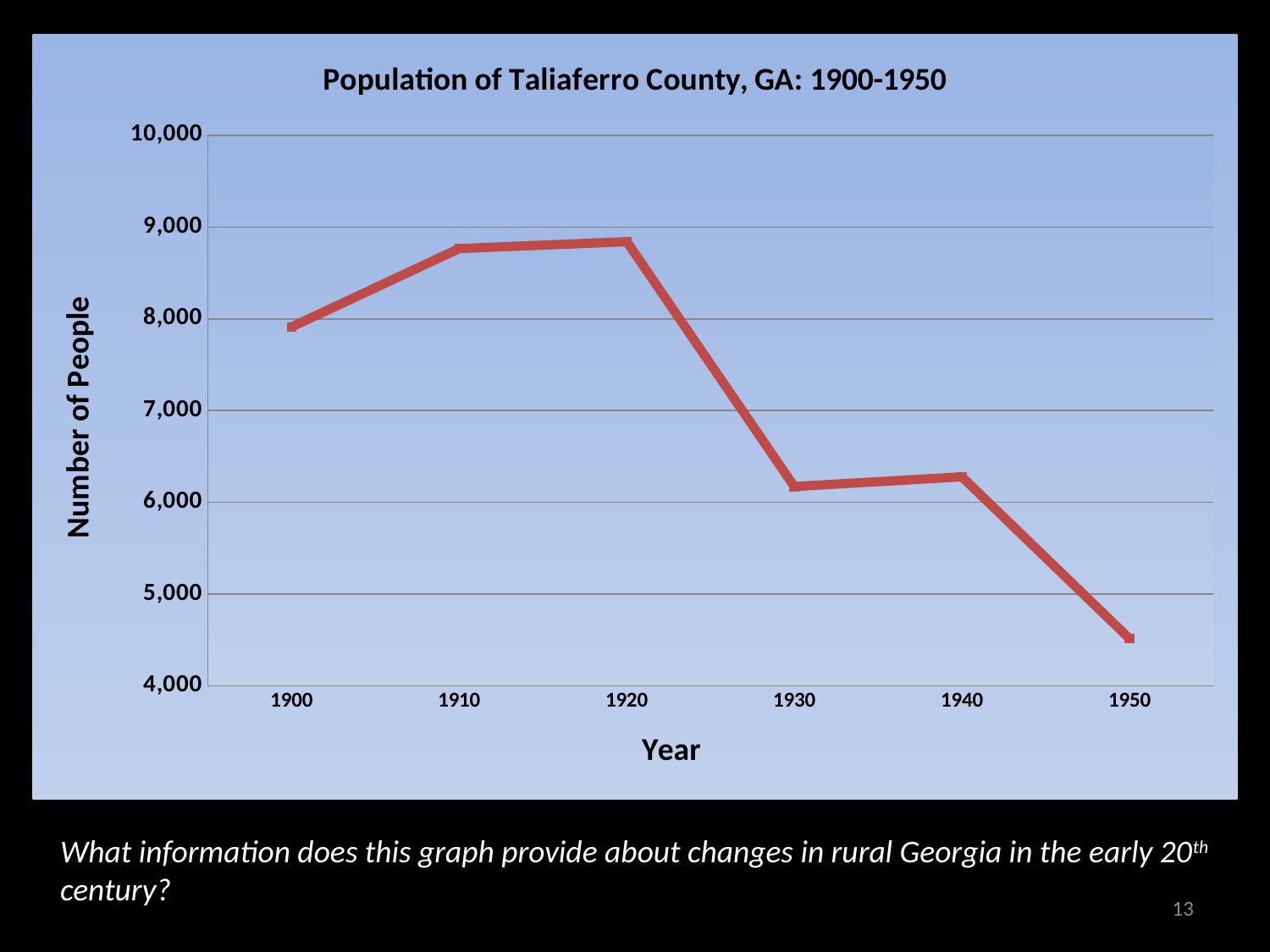
Is the population in 1920 greater or less than 9,000? less Is the population in 1940 greater or less than 7,000? less Which year has the larger population, 1900 or 1950? 1900 What kind of chart is shown on the slide? line chart Is the population in 1910 greater or less than 8,000? greater What is the title of the chart? Population of Taliaferro County, GA: 1900-1950 Does the population rise or fall between 1920 and 1950? fall Which year has the lowest population on the chart? 1950 How many years are plotted on the chart? 6 What is the label on the vertical axis of the chart? Number of People